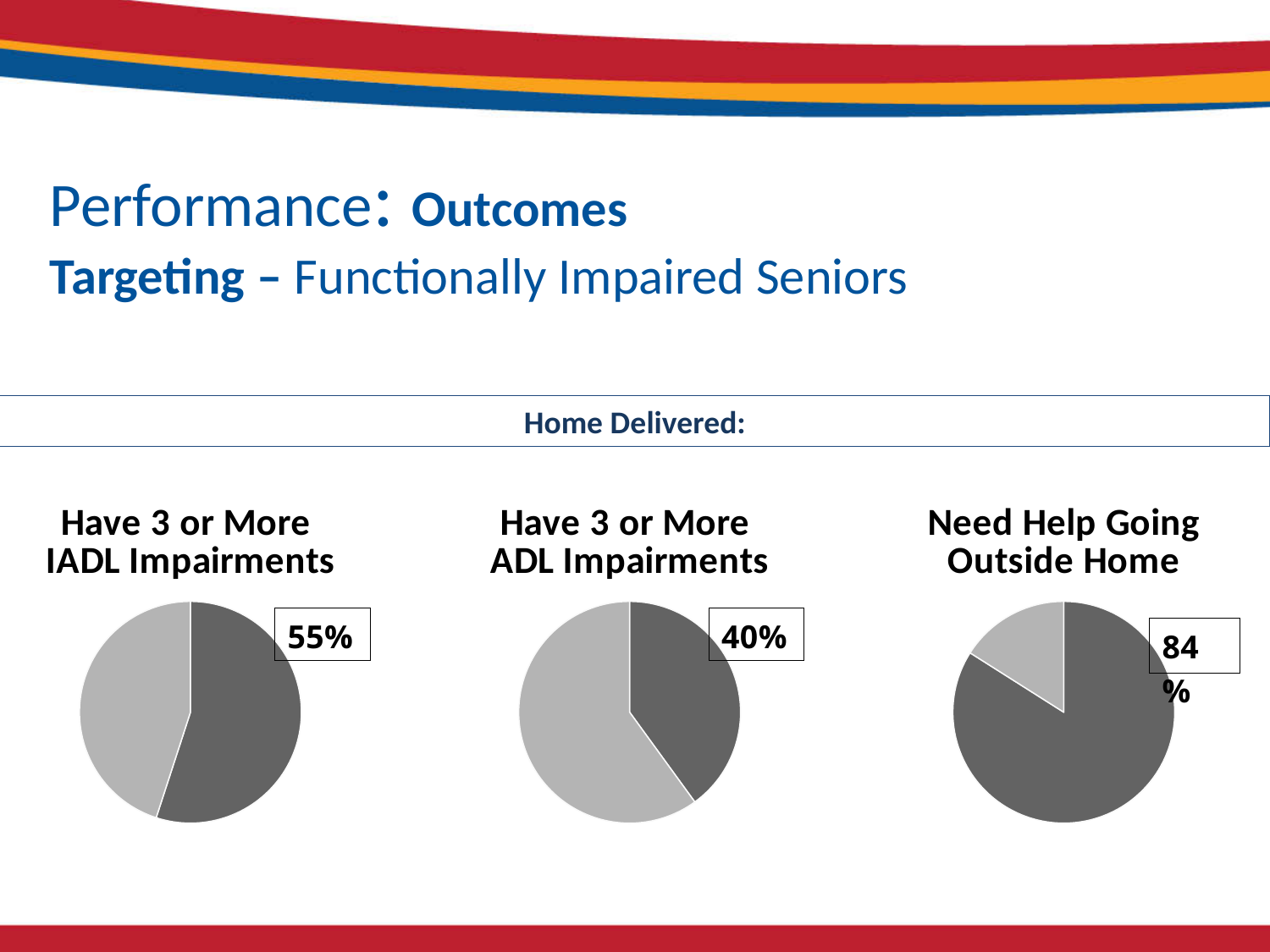
Which is larger: the labelled percentage in the 'Have 3 or More IADL Impairments' chart or in the 'Have 3 or More ADL Impairments' chart? Have 3 or More IADL Impairments What heading appears in the box above the three pie charts? Home Delivered: What is the difference between the labelled percentage in the 'Have 3 or More IADL Impairments' chart and the 'Have 3 or More ADL Impairments' chart? 15% In the 'Need Help Going Outside Home' chart, what percentage is shown for the labelled slice? 84% In the 'Have 3 or More IADL Impairments' chart, what percentage is shown for the labelled slice? 55% What kind of chart is used for 'Have 3 or More IADL Impairments'? Pie chart How many slices does the 'Need Help Going Outside Home' pie chart have? 2 Across the three pie charts, which one shows the lowest labelled percentage? Have 3 or More ADL Impairments How many pie charts are shown on the slide? 3 In the 'Have 3 or More ADL Impairments' chart, what percentage is shown for the labelled slice? 40% What is the difference between the labelled percentage in the 'Need Help Going Outside Home' chart and the 'Have 3 or More ADL Impairments' chart? 44% Across the three pie charts, which one shows the highest labelled percentage? Need Help Going Outside Home